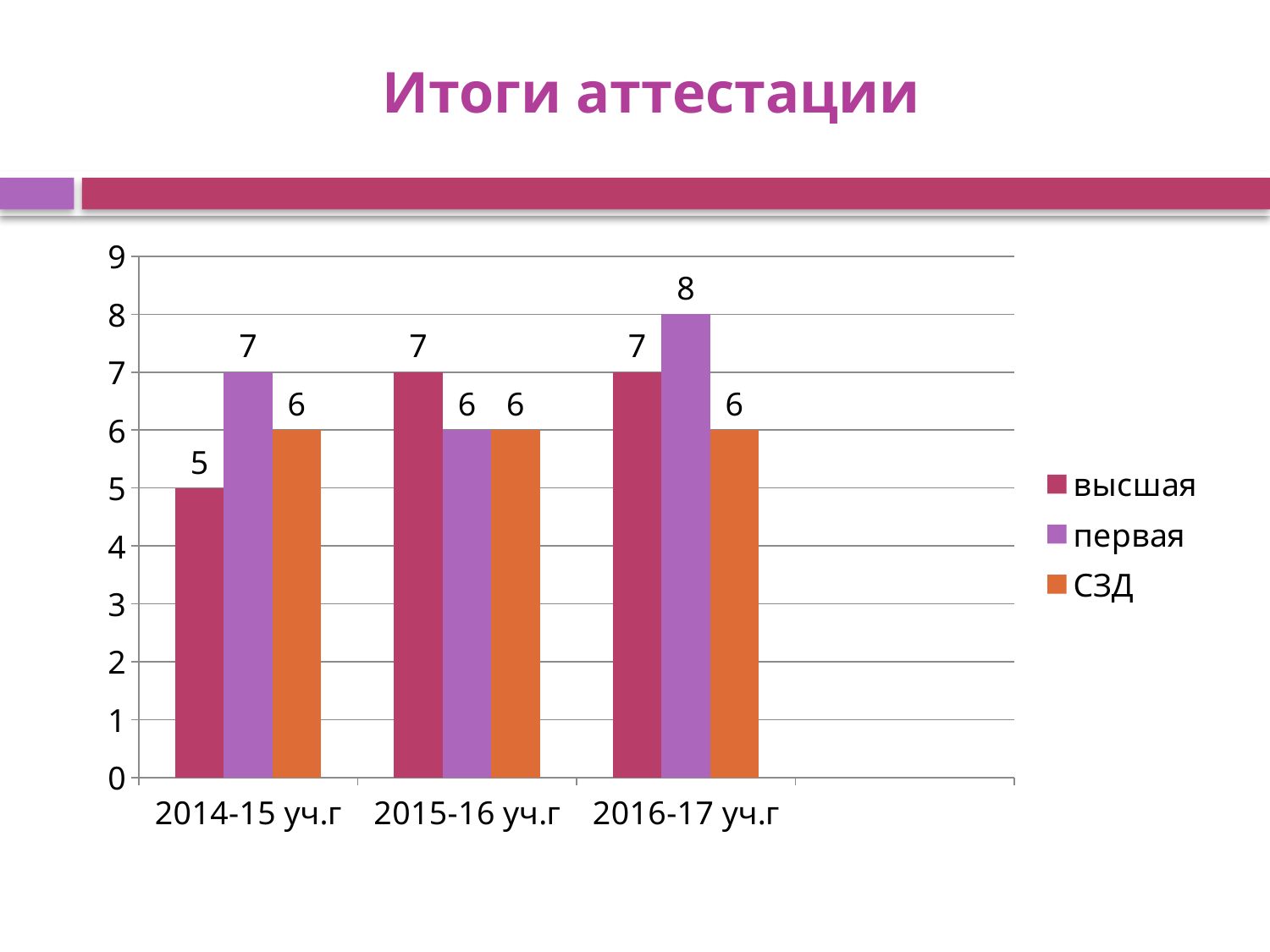
What is the value for СЗД in 2015-16 уч.г? 6 Which year has the highest value for первая? 2016-17 уч.г Does the value for высшая rise or fall from 2014-15 уч.г to 2015-16 уч.г? rise What is the value for высшая in 2014-15 уч.г? 5 What is the title of the slide? Итоги аттестации How many series does the legend list? 3 What is the value for первая in 2016-17 уч.г? 8 Which is larger in 2015-16 уч.г: высшая or первая? высшая What is the difference between первая and высшая in 2014-15 уч.г? 2 What kind of chart is shown on the slide? bar chart Which year has the lowest value for высшая? 2014-15 уч.г How many years are shown on the x axis? 3